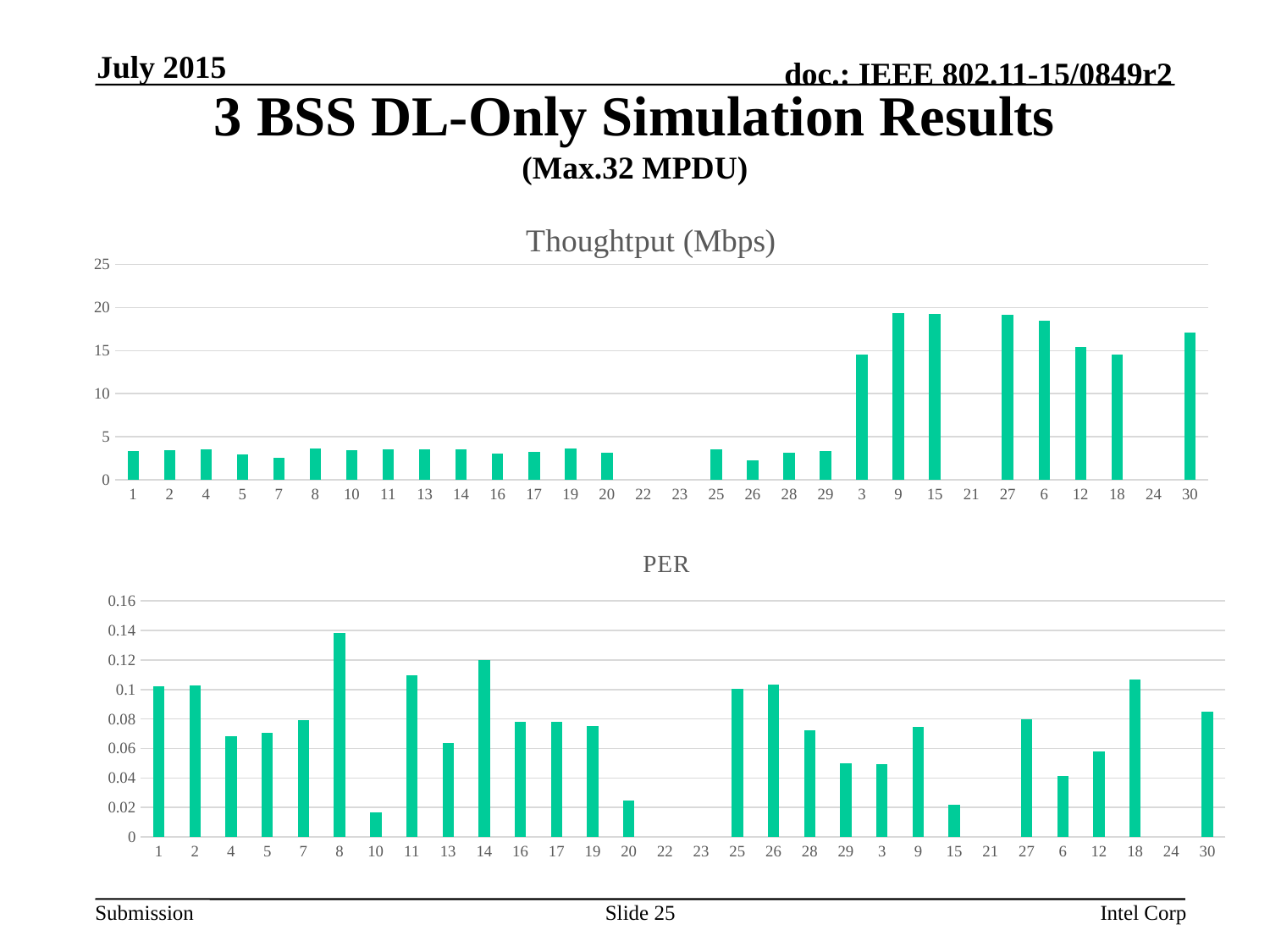
In the top chart (Thoughtput (Mbps)), which has the larger value, category 9 or category 1? 9 In the top chart (Thoughtput (Mbps)), which has the larger value, category 3 or category 30? 30 In the bottom chart (PER), is the value for category 8 greater or less than 0.12? greater In the bottom chart (PER), is the value for category 10 greater or less than 0.04? less In the top chart (Thoughtput (Mbps)), how many categories are labelled on the x axis? 30 In the top chart (Thoughtput (Mbps)), is the value for category 9 greater or less than 15? greater What kind of chart is the top chart titled "Thoughtput (Mbps)"? bar chart In the bottom chart (PER), which has the larger value, category 14 or category 20? 14 What is the title of the bottom chart on the slide? PER In the bottom chart (PER), which category has the highest value? 8